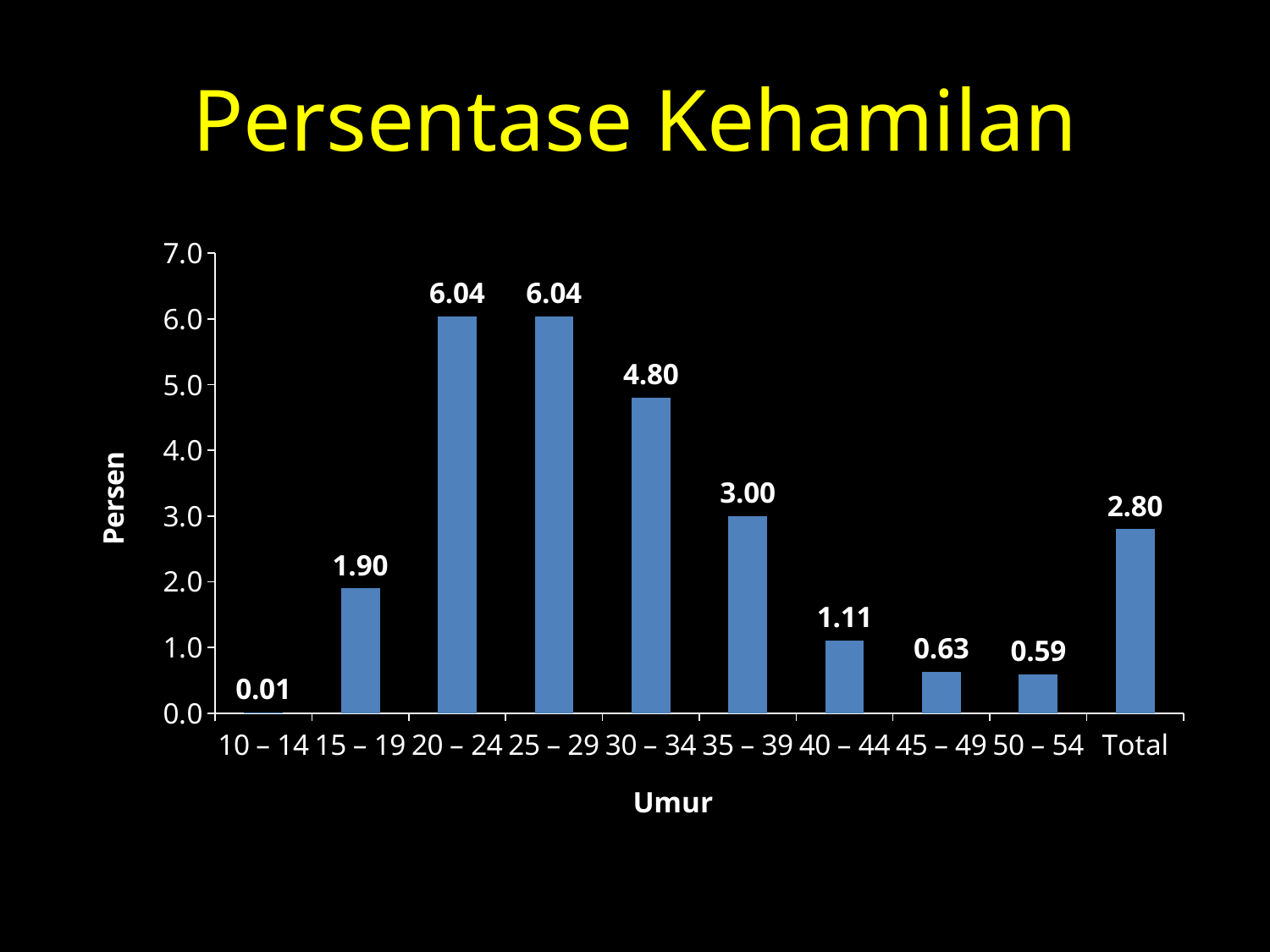
How many categories are shown on the x axis? 10 What is the difference between the values for 15 – 19 and 40 – 44? 0.79 Which age group has the lowest value? 10 – 14 What is the difference between the values for 30 – 34 and 35 – 39? 1.80 Which is larger, the value for 35 – 39 or the value for 40 – 44? 35 – 39 What is the value for the 45 – 49 age group? 0.63 What kind of chart is shown on the slide? bar chart What is the value for the 20 – 24 age group? 6.04 Is the value for 30 – 34 greater or less than 4.0? greater What is the value for the 35 – 39 age group? 3.00 What is the value shown for Total? 2.80 Do the values rise or fall from the 25 – 29 group to the 50 – 54 group? fall